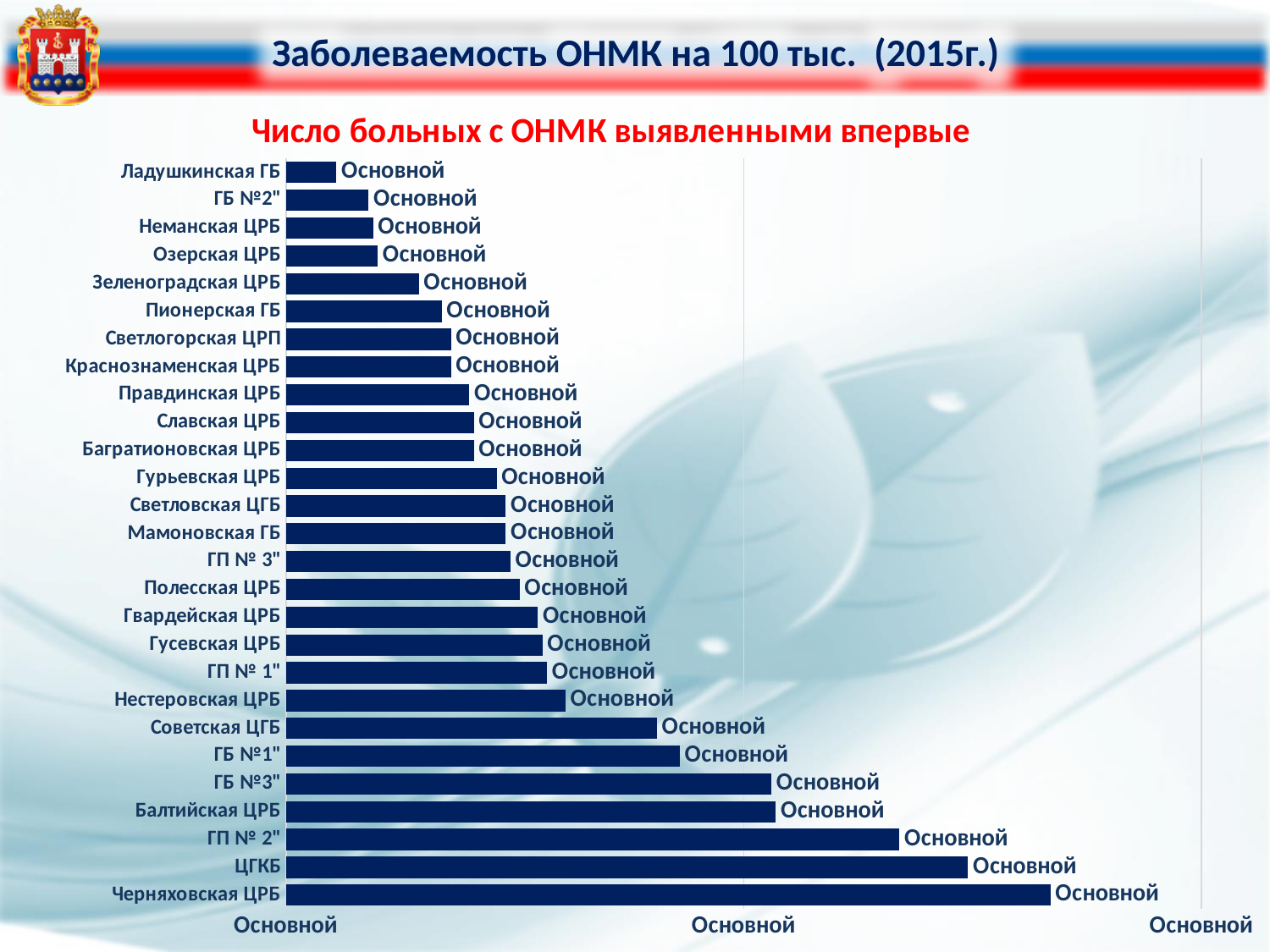
What is the title of the chart? Число больных с ОНМК выявленными впервые What colour are the bars in the chart? dark blue How many categories (medical institutions) are plotted in the chart? 27 Which institution has the longest bar in the chart? Черняховская ЦРБ Which has the larger value, ЦГКБ or ГП № 2"? ЦГКБ Which institution has the shortest bar in the chart? Ладушкинская ГБ Which institution has the second-longest bar in the chart? ЦГКБ Which has the larger value, ГБ №1" or ГБ №3"? ГБ №3" Which has the larger value, Советская ЦГБ or Нестеровская ЦРБ? Советская ЦГБ What kind of chart is shown on the slide? bar chart